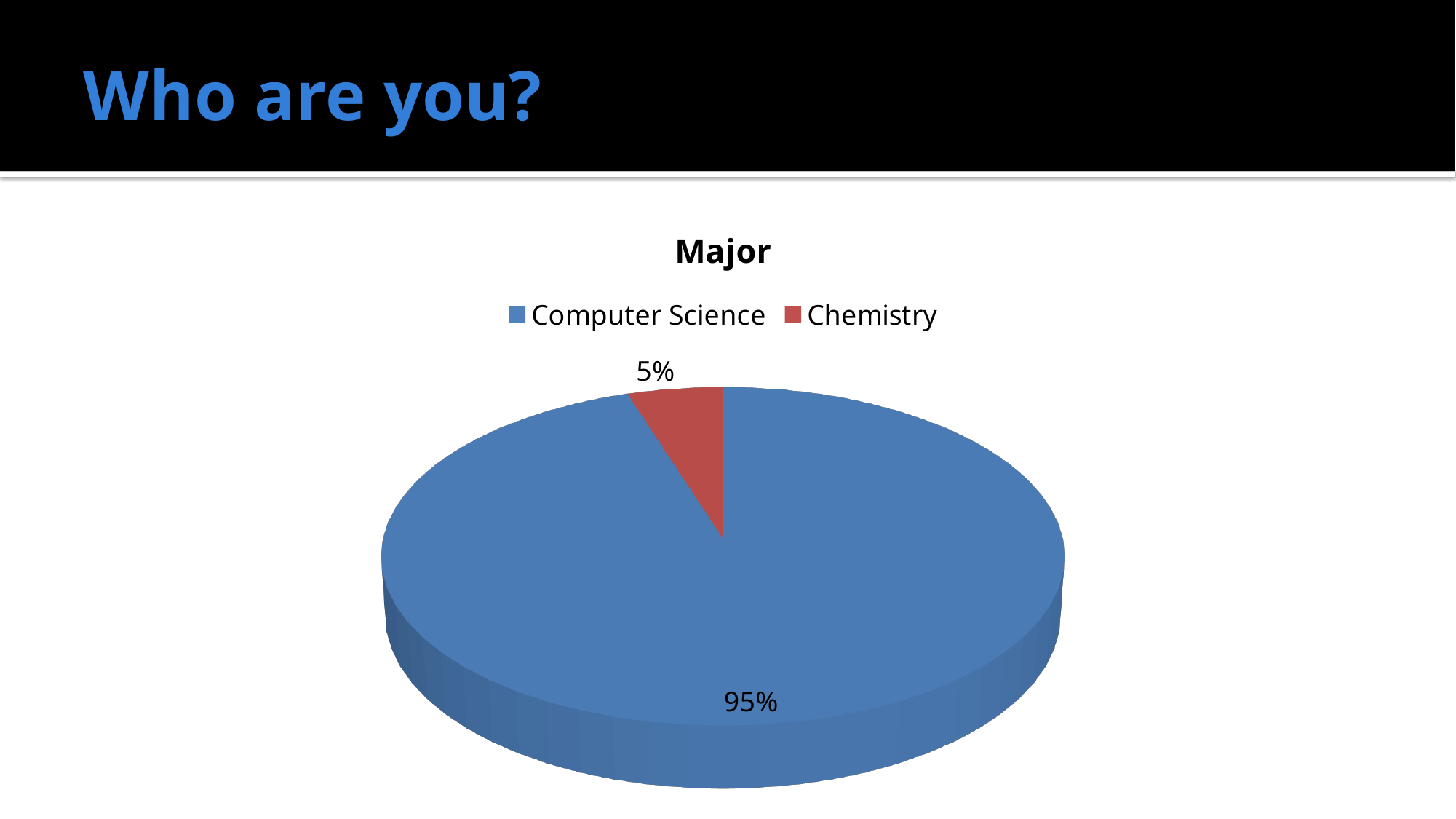
What is the title of the chart? Major What colour is the Chemistry slice? red How many categories does the pie chart show? 2 What kind of chart is shown on the slide? pie chart What share of the pie does Computer Science have? 95% Which category has the smallest slice of the pie? Chemistry What is the difference in percentage points between the Computer Science and Chemistry slices? 90 What share of the pie does Chemistry have? 5% Which category has the largest slice of the pie? Computer Science Which is larger, the Computer Science slice or the Chemistry slice? Computer Science How many entries does the legend list? 2